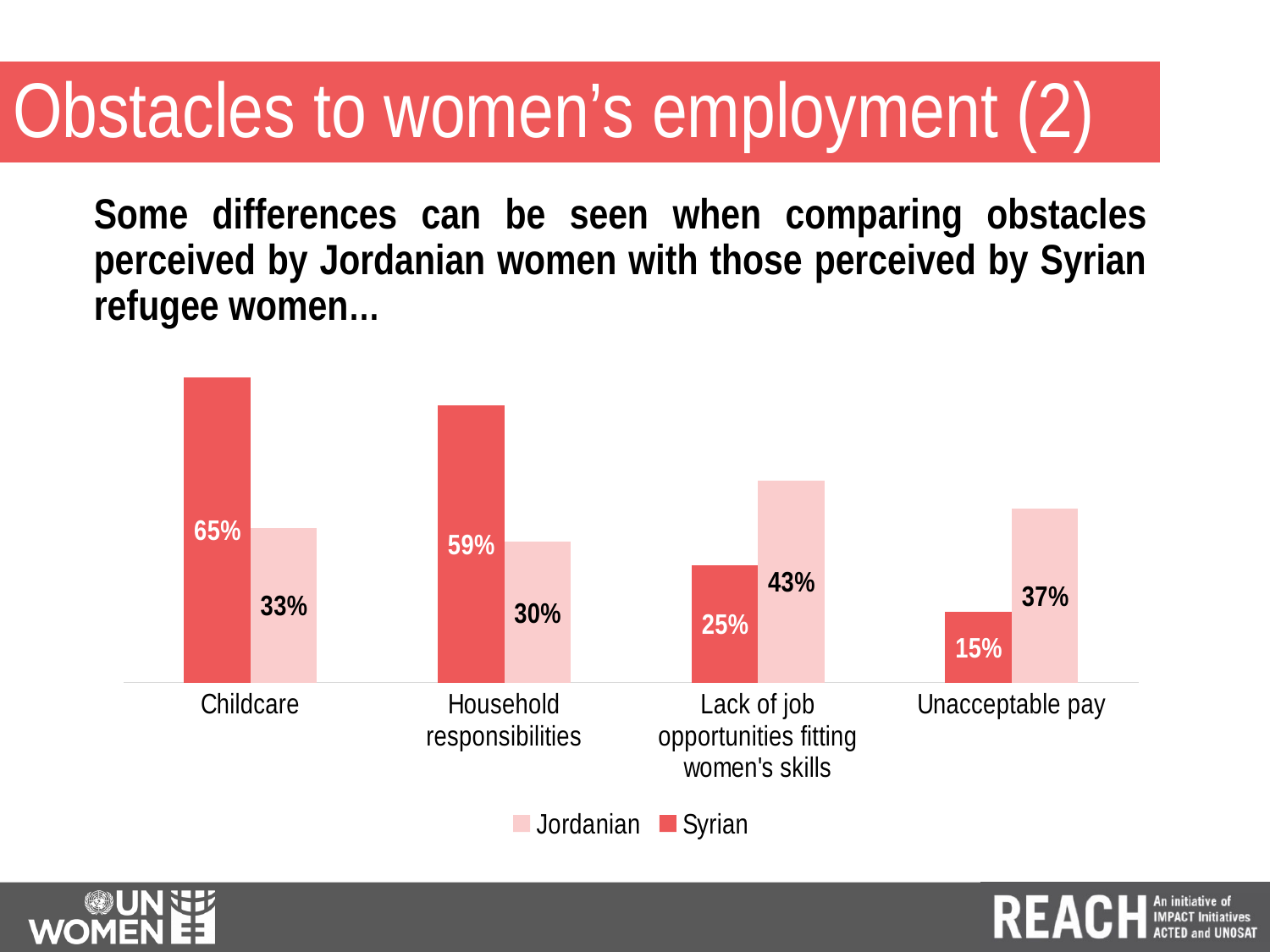
Which obstacle has the highest value for Syrian women? Childcare What is the value for Syrian women under Household responsibilities? 59% Which obstacle has the lowest value for Jordanian women? Household responsibilities What is the value for Jordanian women under Unacceptable pay? 37% What type of chart is shown on the slide? Bar chart What percentage of Syrian women cited Childcare as an obstacle? 65% For Unacceptable pay, which group has the larger value, Jordanian or Syrian? Jordanian Which colour represents the Syrian series in the legend? Red What is the difference between the Syrian and Jordanian values for Childcare? 32 percentage points How many series does the legend list? 2 What percentage of Jordanian women cited Lack of job opportunities fitting women's skills as an obstacle? 43% How many obstacle categories are shown on the x axis? 4